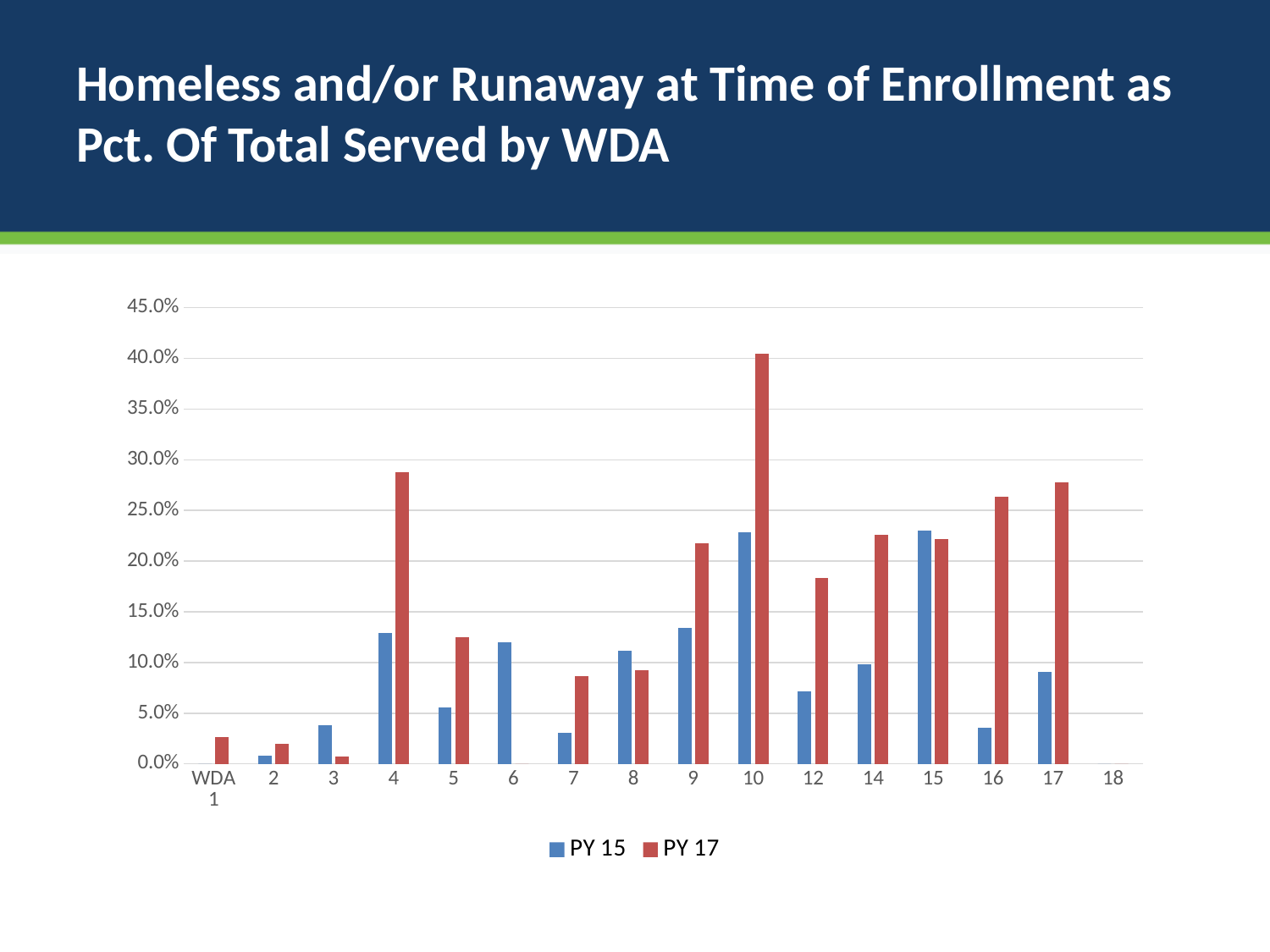
How many WDA categories are shown on the x axis? 16 How many series does the legend list? 2 Is the PY 17 value for WDA 3 greater or less than 5.0%? less Is the PY 17 value for WDA 4 greater or less than 25.0%? greater What are the two series named in the legend? PY 15 and PY 17 Which colour represents the PY 17 series? red For WDA 4, which series has the larger value, PY 15 or PY 17? PY 17 For WDA 8, which series has the larger value, PY 15 or PY 17? PY 15 Is the PY 15 value for WDA 6 greater or less than 10.0%? greater What kind of chart is shown on the slide? bar chart Which WDA has the highest PY 17 value? 10